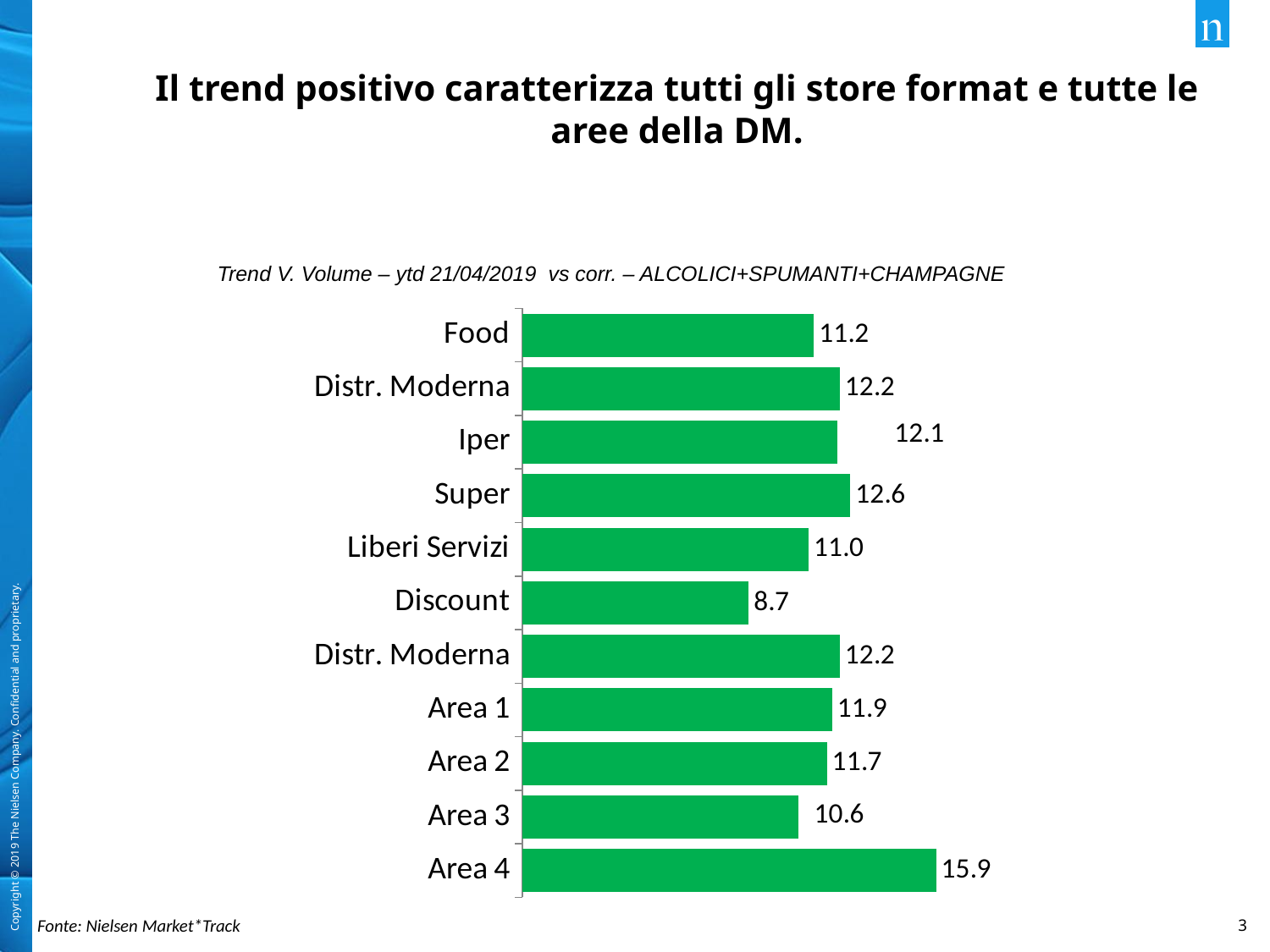
What is the value for Liberi Servizi? 11.0 Which category has the highest value? Area 4 What is the value for Discount? 8.7 What is the difference between the values for Super and Discount? 3.9 Which category has the lowest value? Discount What type of chart is shown on the slide? Bar chart What is the difference between the values for Area 4 and Area 3? 5.3 What is the value for Distr. Moderna? 12.2 What is the value for Area 4? 15.9 What is the value for Super? 12.6 Which is larger, the value for Area 1 or the value for Area 2? Area 1 How many bars are shown in the chart? 11